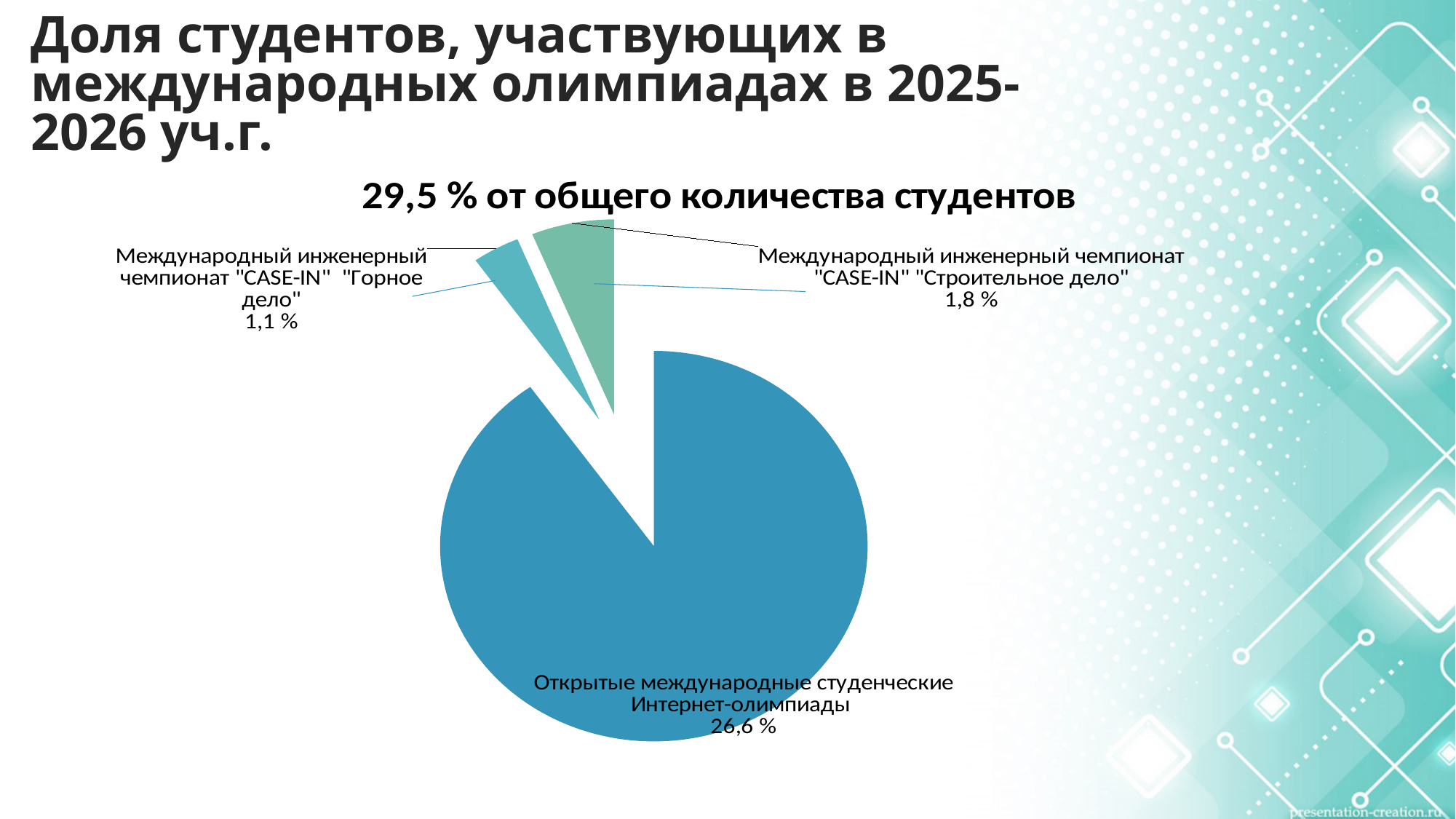
What kind of chart is shown on the slide? Pie chart What is the total of the three slice values shown on the chart? 29,5 % Which is larger: the value for "CASE-IN" "Строительное дело" or for "CASE-IN" "Горное дело"? "CASE-IN" "Строительное дело" Which category has the largest slice of the pie? Открытые международные студенческие Интернет-олимпиады Which category has the smallest slice of the pie? Международный инженерный чемпионат "CASE-IN" "Горное дело" What is the value for Международный инженерный чемпионат "CASE-IN" "Строительное дело"? 1,8 % What is the value for Открытые международные студенческие Интернет-олимпиады? 26,6 % What is the difference between the value for Открытые международные студенческие Интернет-олимпиады and the value for "CASE-IN" "Строительное дело"? 24,8 % What is the title of the chart? 29,5 % от общего количества студентов What is the difference between the value for "CASE-IN" "Строительное дело" and the value for "CASE-IN" "Горное дело"? 0,7 % What is the value for Международный инженерный чемпионат "CASE-IN" "Горное дело"? 1,1 % How many slices does the pie chart have? 3